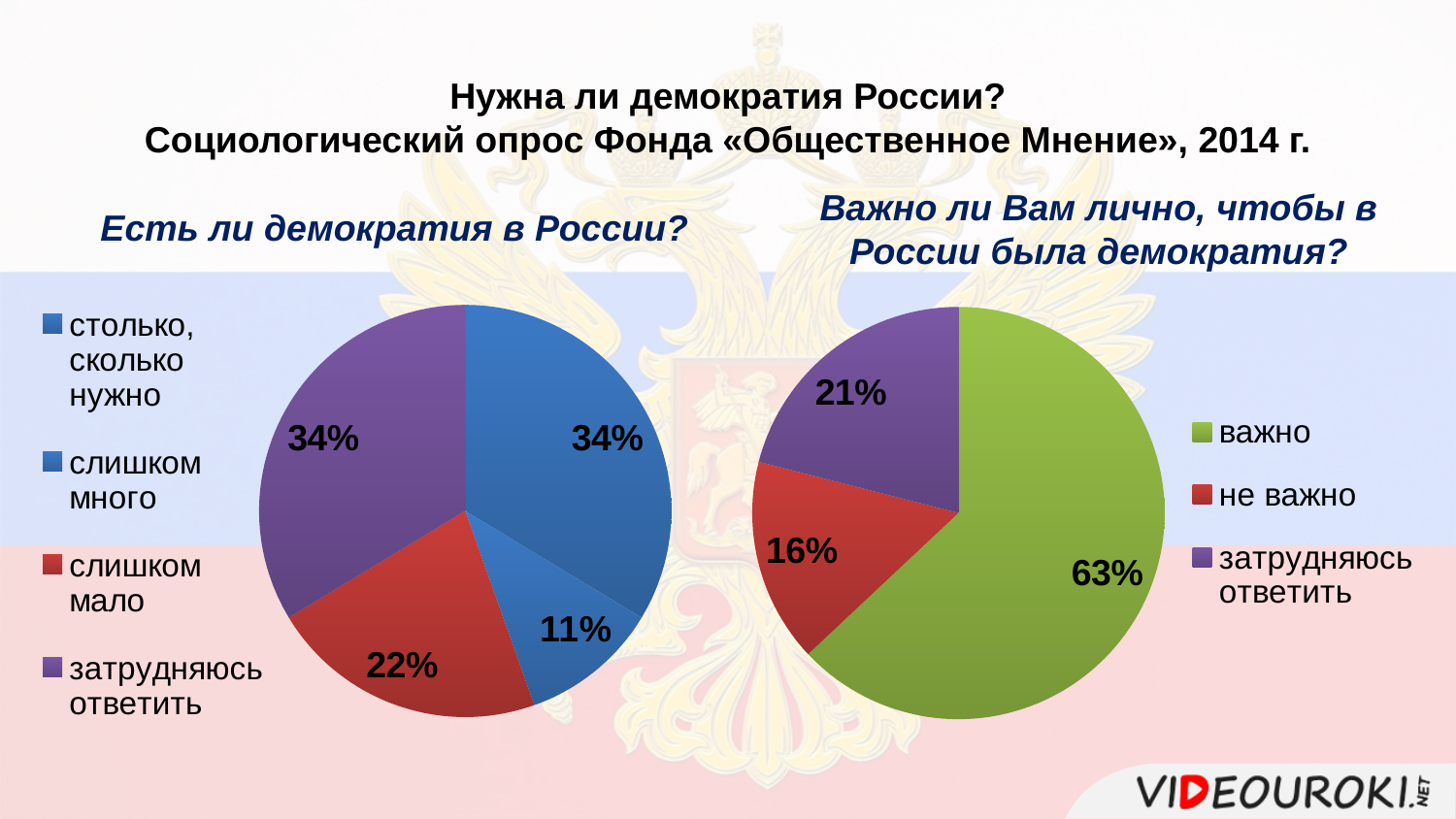
In the left chart "Есть ли демократия в России?", which category has the smallest slice? слишком много In the left chart "Есть ли демократия в России?", what share is labelled for "слишком мало"? 22% In the left chart "Есть ли демократия в России?", what share is labelled for "слишком много"? 11% In the right chart "Важно ли Вам лично, чтобы в России была демократия?", which category has the smallest slice? не важно In the right chart "Важно ли Вам лично, чтобы в России была демократия?", which is larger: "затрудняюсь ответить" or "не важно"? затрудняюсь ответить In the right chart "Важно ли Вам лично, чтобы в России была демократия?", what is the difference between the shares for "важно" and "затрудняюсь ответить"? 42% What type of chart is used for both charts on the slide? pie chart In the right chart "Важно ли Вам лично, чтобы в России была демократия?", what share is labelled for "не важно"? 16% In the right chart "Важно ли Вам лично, чтобы в России была демократия?", which category has the largest slice? важно In the left chart "Есть ли демократия в России?", how many categories does the legend list? 4 In the right chart "Важно ли Вам лично, чтобы в России была демократия?", what share is labelled for "важно"? 63% In the left chart "Есть ли демократия в России?", what is the difference between the shares for "слишком мало" and "слишком много"? 11%